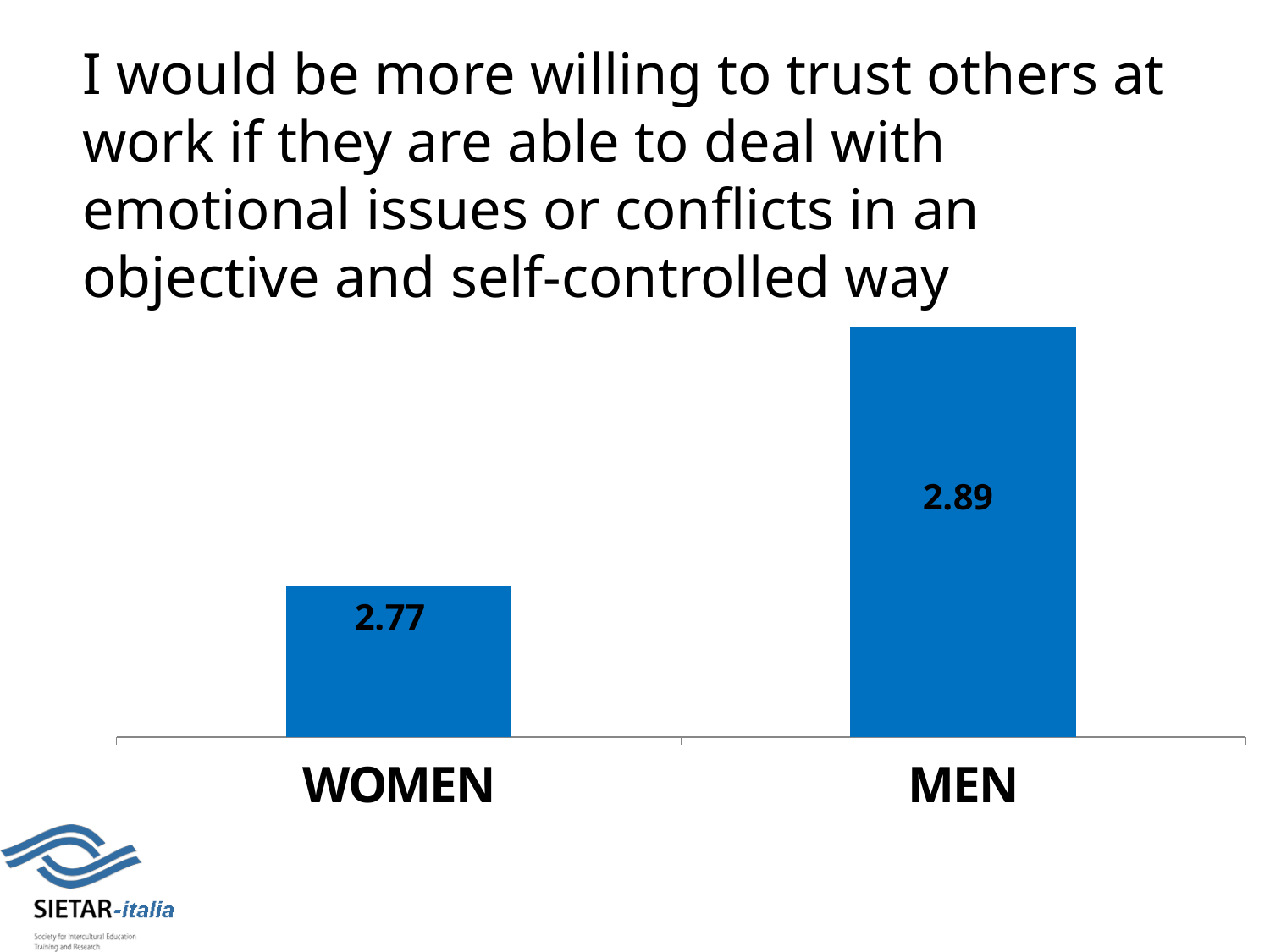
Do the values rise or fall from WOMEN to MEN? Rise What are the two category labels on the x axis? WOMEN and MEN What is the value for WOMEN? 2.77 How many categories are shown in the chart? 2 What is the value for MEN? 2.89 Which category has the highest value? MEN What colour are the bars in the chart? Blue What kind of chart is shown on the slide? Bar chart Which category has the lowest value? WOMEN Which is larger, the value for WOMEN or the value for MEN? MEN What is the difference between the values for MEN and WOMEN? 0.12